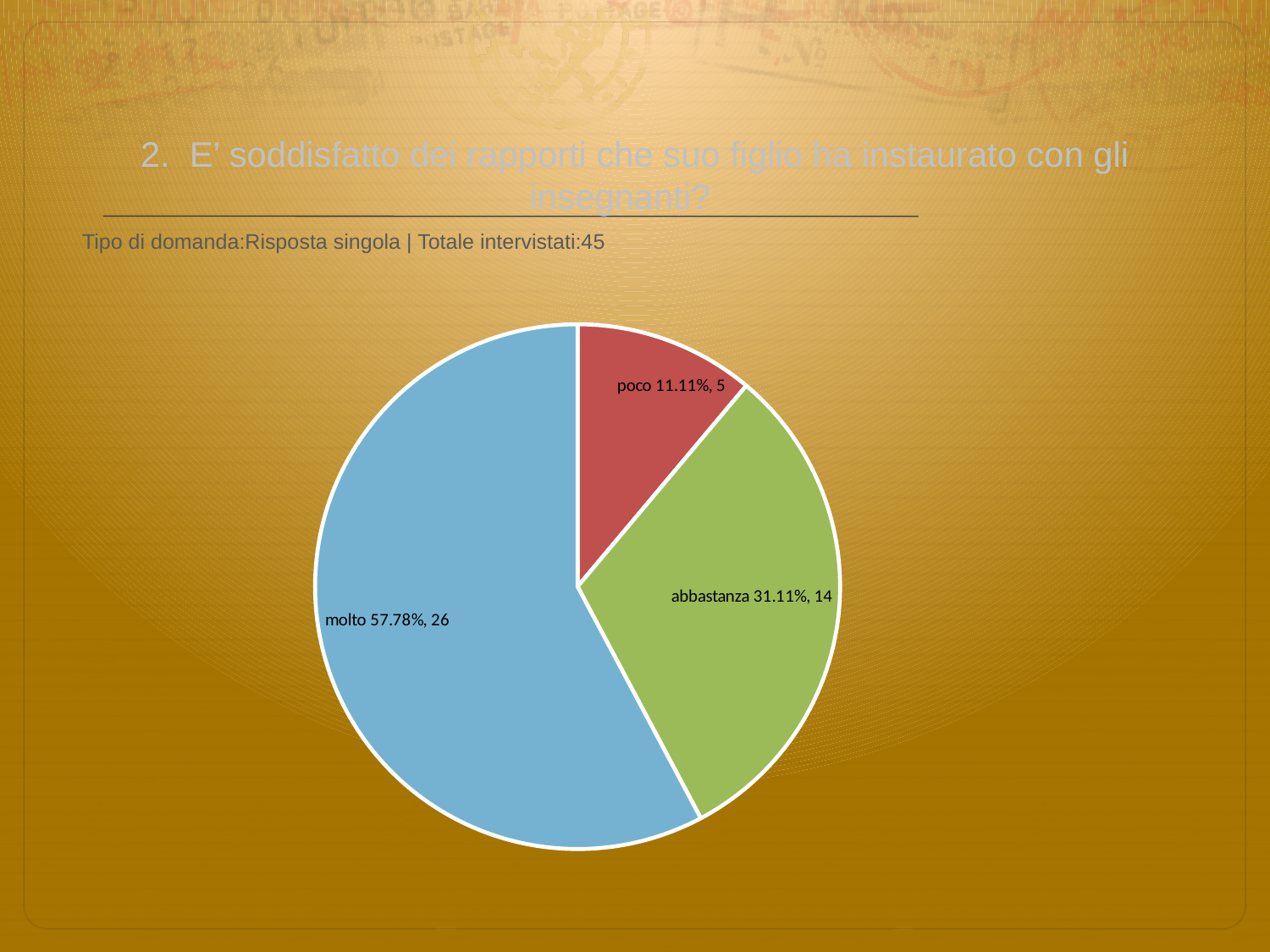
How many respondents answered 'molto'? 26 Which category has the largest slice? molto What percentage share does the 'molto' slice have? 57.78% What is the difference in respondent count between 'molto' and 'abbastanza'? 12 What kind of chart is shown on the slide? pie chart What percentage share does the 'poco' slice have? 11.11% What percentage share does the 'abbastanza' slice have? 31.11% Which has more respondents, 'abbastanza' or 'poco'? abbastanza How many respondents answered 'abbastanza'? 14 How many respondents answered 'poco'? 5 How many slices does the pie chart have? 3 Which category has the smallest slice? poco